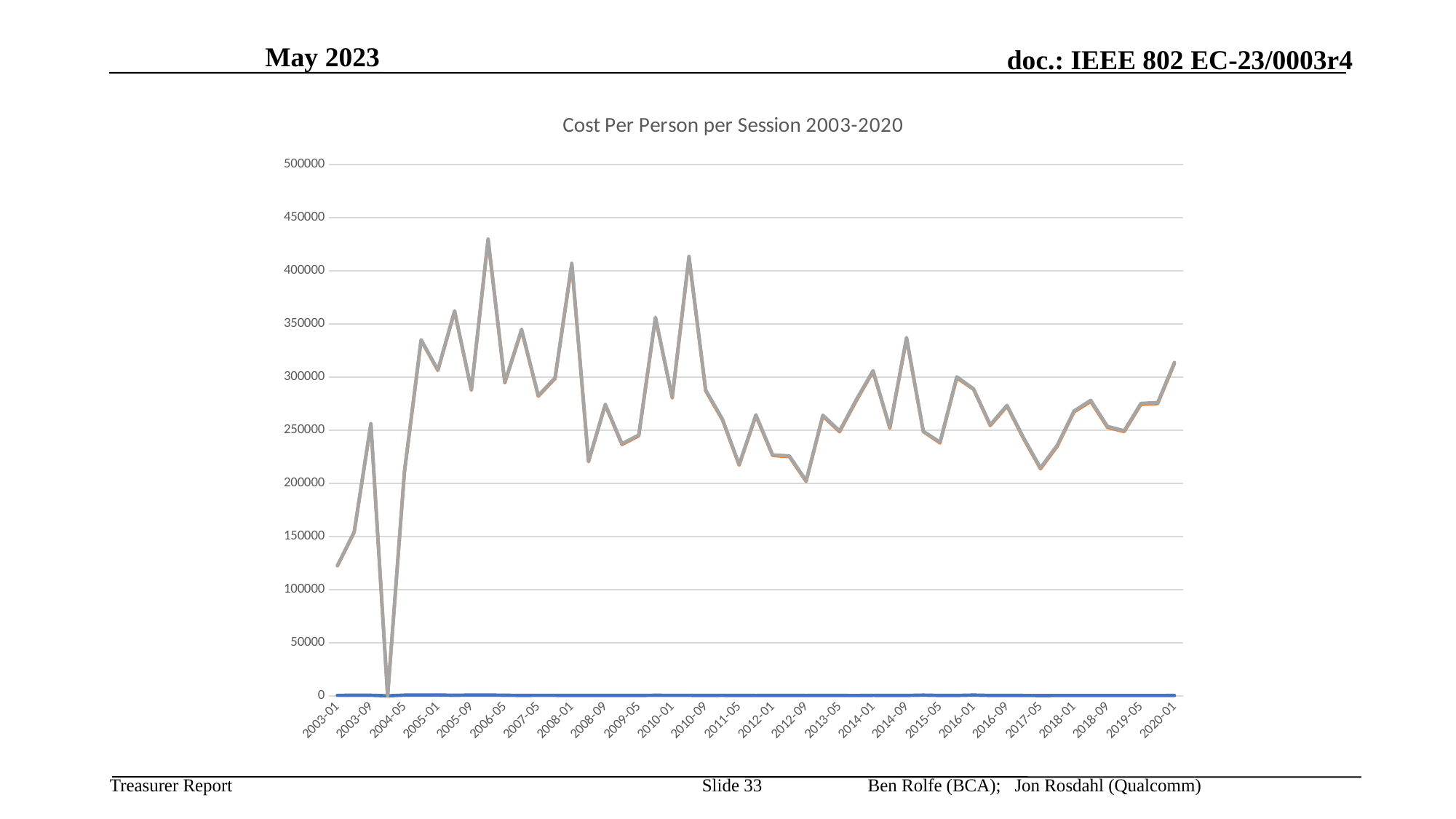
Which is larger on the gray line, the value at 2006-05 or the value at 2020-01? 2020-01 What type of chart is shown on the slide? line chart Which is larger on the gray line, the value at 2003-01 or the value at 2005-01? 2005-01 Is the value of the gray line at 2020-01 greater or less than 300000? greater Is the value of the gray line at 2004-05 greater or less than 50000? greater What is the title of the chart? Cost Per Person per Session 2003-2020 Is the value of the gray line at 2006-05 greater or less than 400000? less How many labels are shown on the x axis? 26